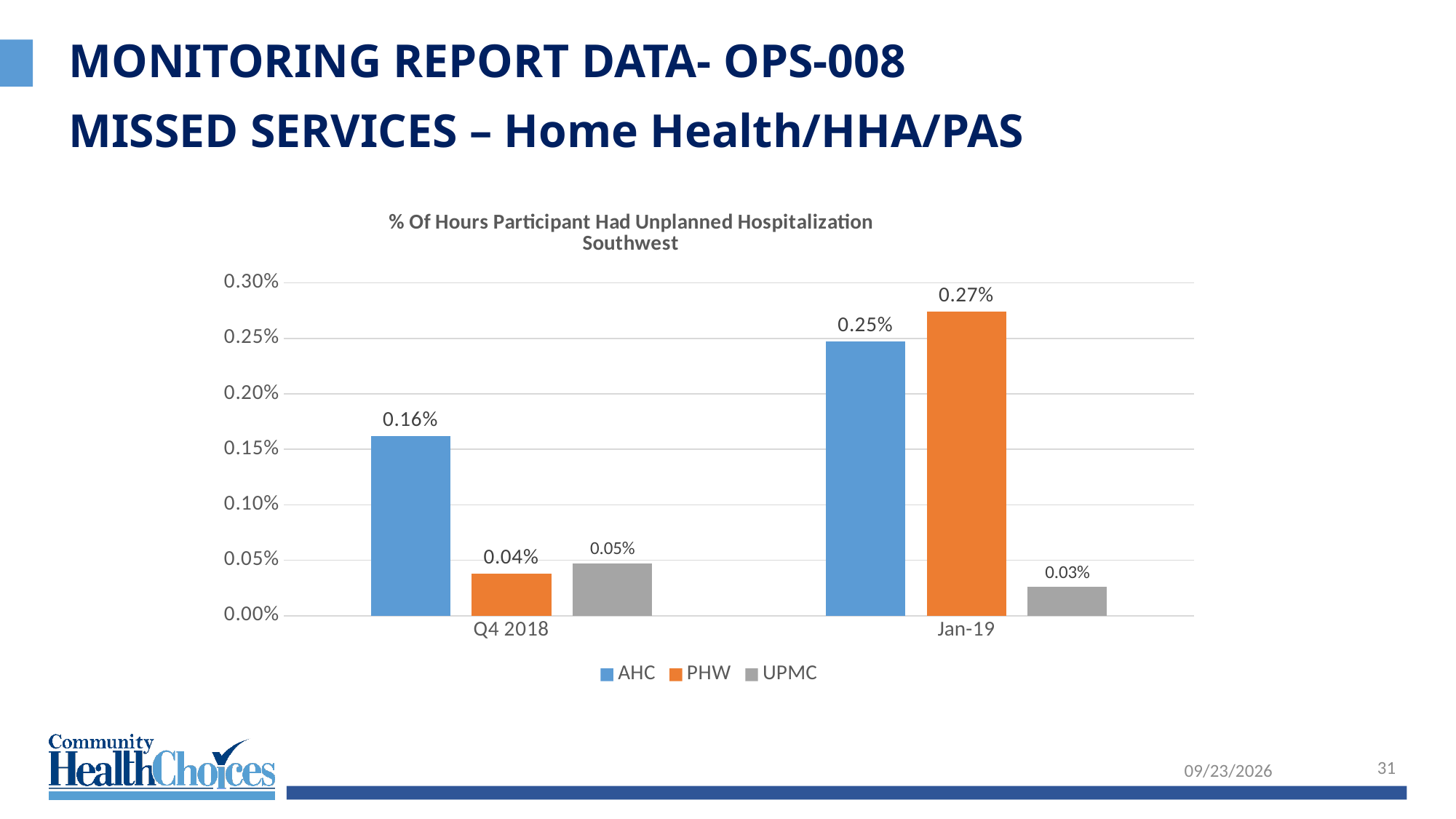
Which series has the lowest value in Q4 2018? PHW What is the value for PHW in Jan-19? 0.27% Is the value for PHW in Jan-19 greater or less than 0.25%? greater How many categories are shown on the x axis? 2 How many series does the legend list? 3 Which is larger: the UPMC value in Q4 2018 or the UPMC value in Jan-19? Q4 2018 Does the PHW value rise or fall from Q4 2018 to Jan-19? Rise What is the value for AHC in Q4 2018? 0.16% What is the difference between the AHC values in Jan-19 and Q4 2018? 0.09% Which series has the highest value in Jan-19? PHW What is the value for UPMC in Q4 2018? 0.05% What kind of chart is shown on the slide? Bar chart